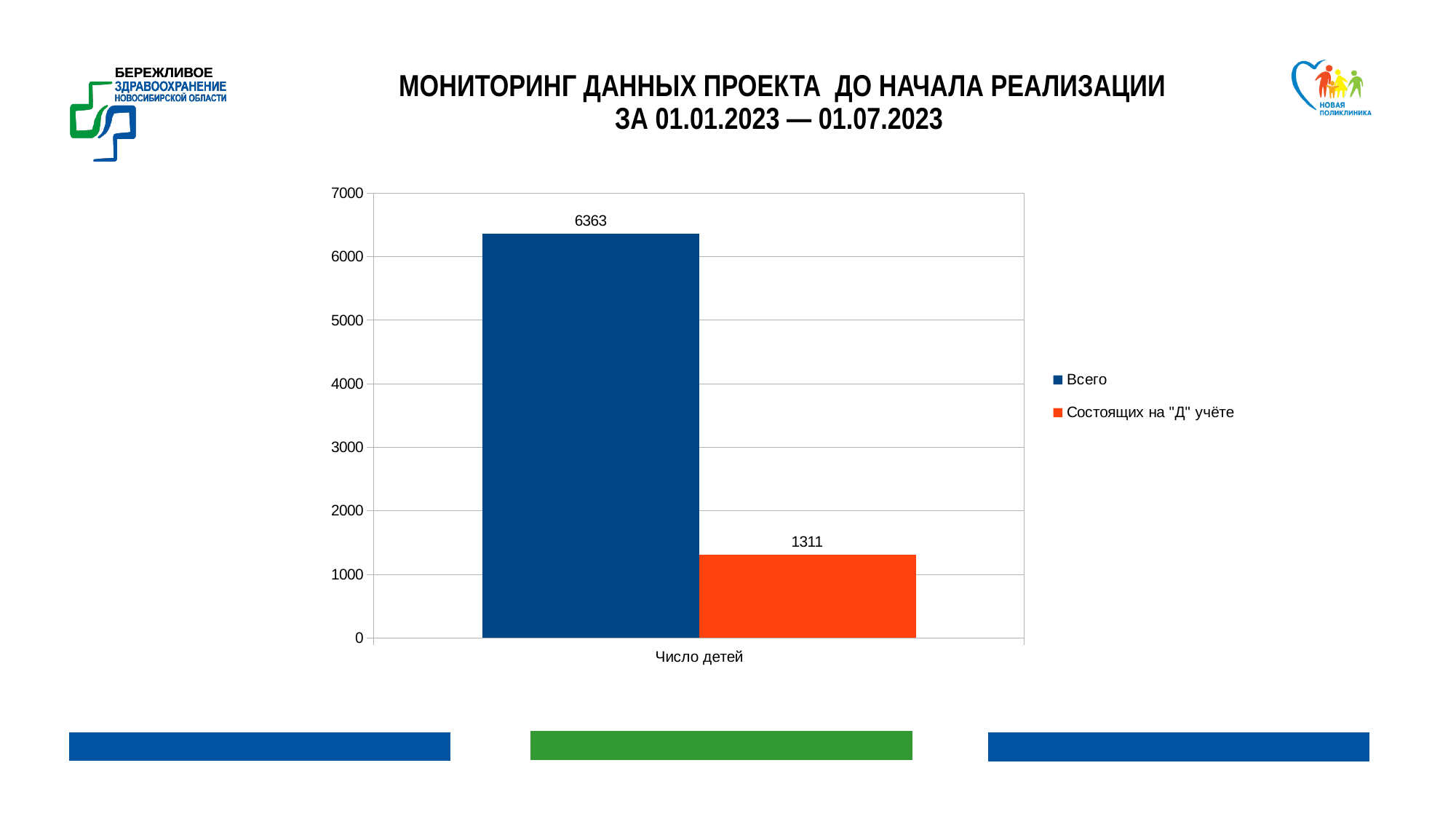
How many series does the legend list? 2 What colour is the bar for the "Всего" series? dark blue What is the label of the category on the x axis? Число детей Is the value for "Состоящих на "Д" учёте" greater or less than 2000? less Which series has the higher value: "Всего" or "Состоящих на "Д" учёте"? Всего What is the value of the "Состоящих на "Д" учёте" series for "Число детей"? 1311 What is the maximum value shown on the y axis? 7000 What is the difference between the "Всего" value and the "Состоящих на "Д" учёте" value? 5052 Is the value for "Всего" greater or less than 6000? greater What kind of chart is shown on the slide? bar chart How many categories are shown on the x axis? 1 What is the value of the "Всего" series for "Число детей"? 6363